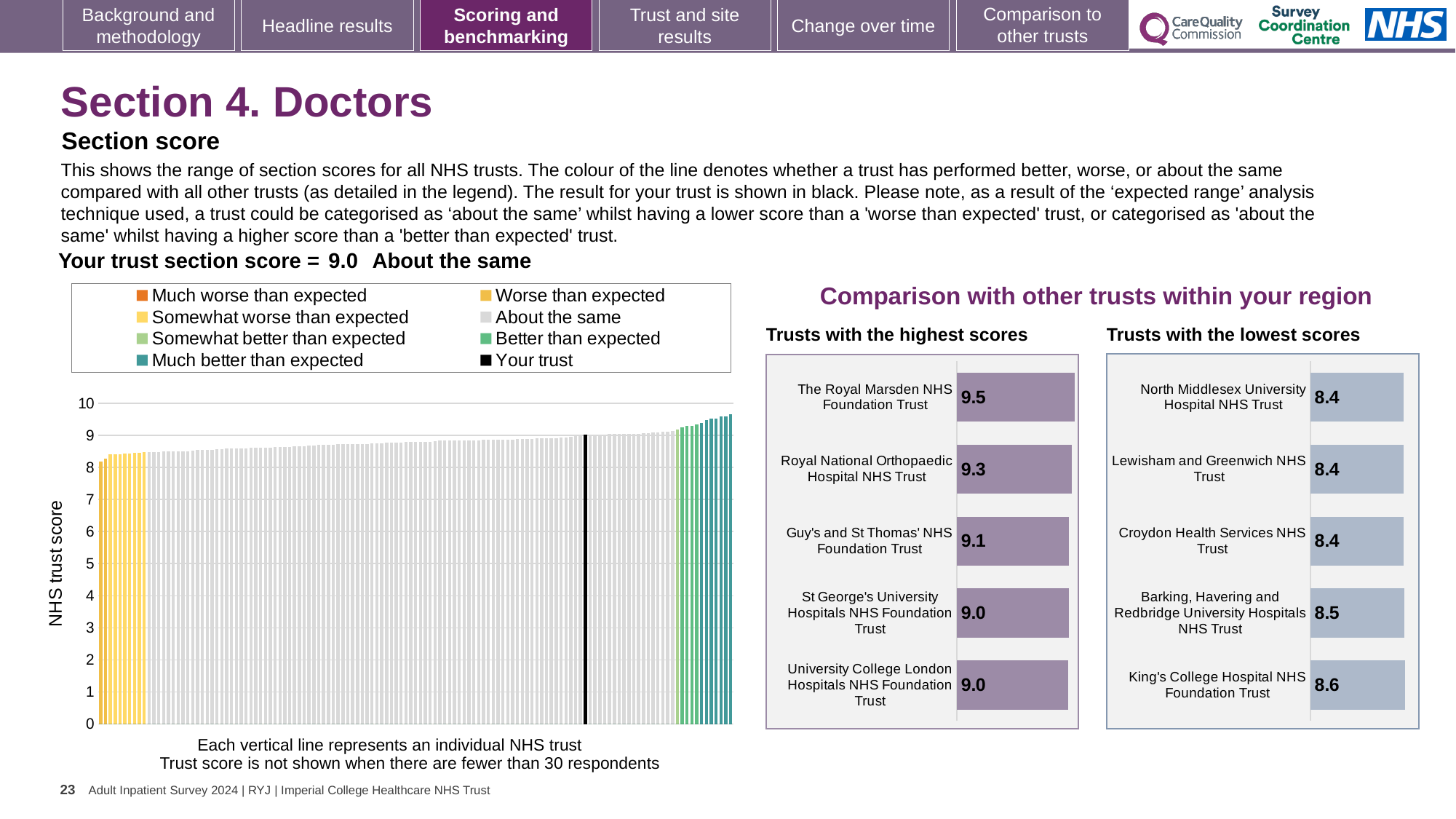
What kind of chart is the 'Trusts with the highest scores' chart? Bar chart In the NHS trust score chart on the left, is the value for the black 'Your trust' bar greater or less than 8? greater In the NHS trust score chart on the left, do the values rise or fall from left to right along the x axis? Rise In the 'Trusts with the lowest scores' chart, what is the score for King's College Hospital NHS Foundation Trust? 8.6 In the 'Trusts with the highest scores' chart, which trust has the highest score? The Royal Marsden NHS Foundation Trust How many entries does the legend of the NHS trust score chart on the left list? 8 In the 'Trusts with the highest scores' chart, what is the score for The Royal Marsden NHS Foundation Trust? 9.5 In the 'Trusts with the highest scores' chart, what is the score for Guy's and St Thomas' NHS Foundation Trust? 9.1 In the 'Trusts with the highest scores' chart, what is the difference between the scores of The Royal Marsden NHS Foundation Trust and Guy's and St Thomas' NHS Foundation Trust? 0.4 In the 'Trusts with the lowest scores' chart, which trust has the highest score? King's College Hospital NHS Foundation Trust In the 'Trusts with the lowest scores' chart, which has the larger score: King's College Hospital NHS Foundation Trust or Barking, Havering and Redbridge University Hospitals NHS Trust? King's College Hospital NHS Foundation Trust How many trusts are shown in the 'Trusts with the lowest scores' chart? 5